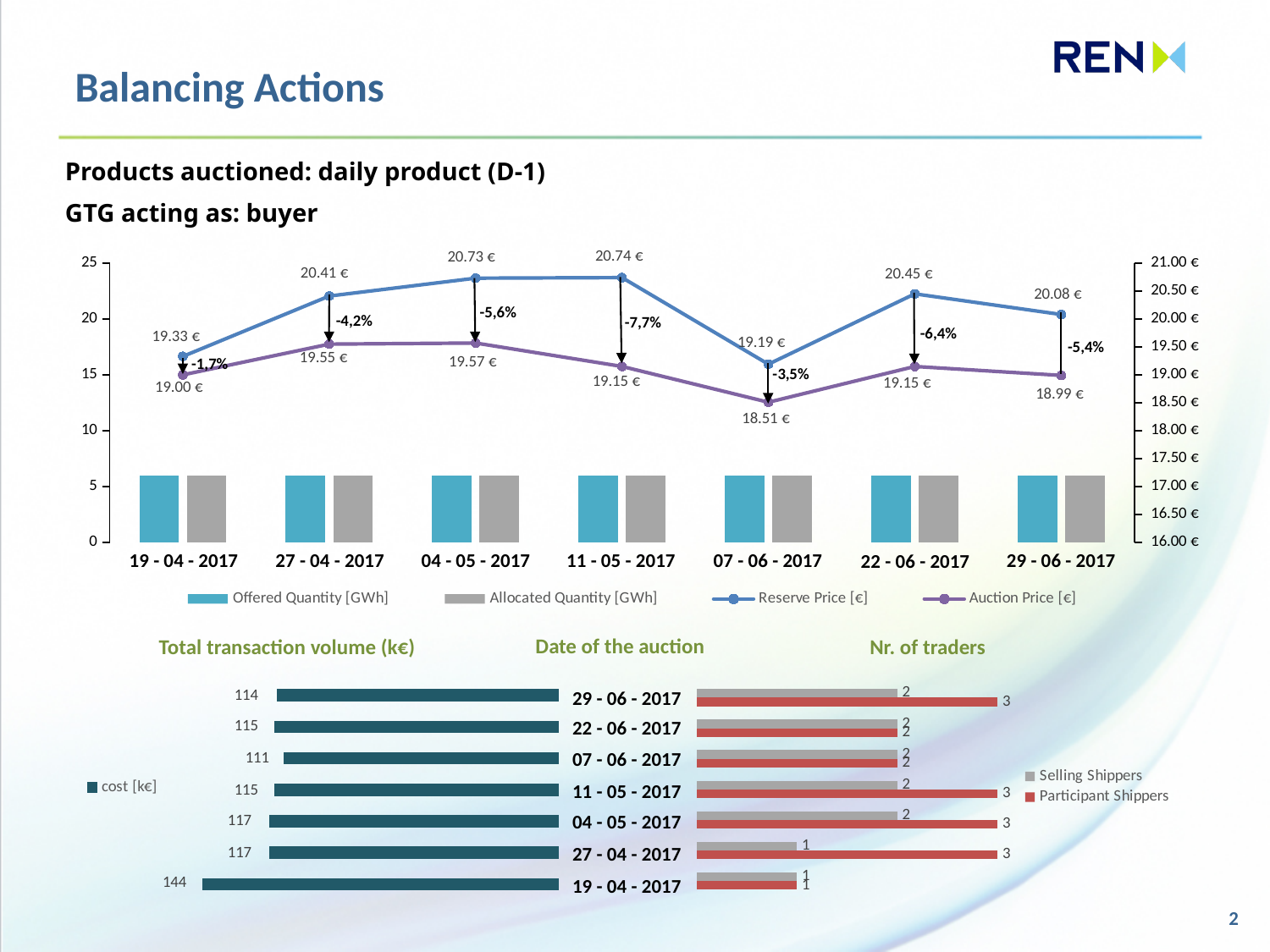
How many series does the legend of the top chart list? 4 In the top chart, what percentage change is labelled between the Reserve Price and Auction Price on 11 - 05 - 2017? -7,7% In the top chart, what is the Reserve Price on 11 - 05 - 2017? 20.74 € In the top chart, what is the difference between the Reserve Price and the Auction Price on 19 - 04 - 2017? 0.33 € What kind of chart is the 'Total transaction volume (k€)' chart? bar chart How many auction dates are shown on the x axis of the top chart? 7 In the 'Nr. of traders' chart, how many Participant Shippers are shown for 27 - 04 - 2017? 3 In the top chart, on which date is the Auction Price lowest? 07 - 06 - 2017 In the 'Total transaction volume (k€)' chart, what is the cost for 07 - 06 - 2017? 111 In the top chart, what is the Auction Price on 07 - 06 - 2017? 18.51 € In the 'Total transaction volume (k€)' chart, which has the larger cost: 19 - 04 - 2017 or 29 - 06 - 2017? 19 - 04 - 2017 In the 'Total transaction volume (k€)' chart, which date has the highest cost? 19 - 04 - 2017